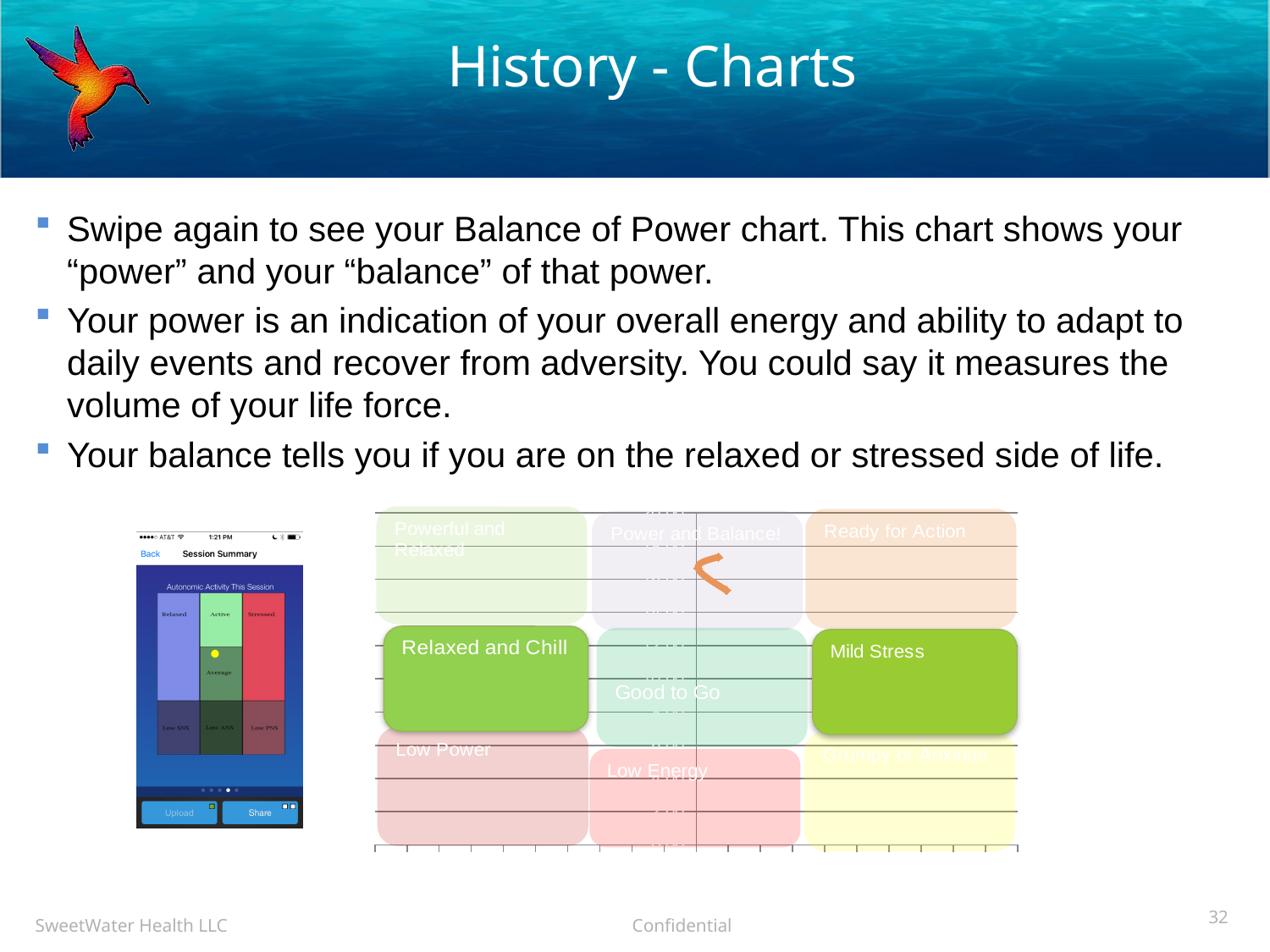
On the phone screenshot chart on the left, which column contains the yellow dot marker? Active On the phone screenshot chart on the left, how many columns are shown in the top row (Relaxed, Active, Stressed)? 3 On the Balance of Power chart on the right, what is the label of the top-right zone? Ready for Action On the Balance of Power chart on the right, what is the label of the bottom-left zone? Low Power On the Balance of Power chart on the right, how many labeled zones are shown? 9 On the Balance of Power chart on the right, which zone contains the orange marker? Power and Balance!